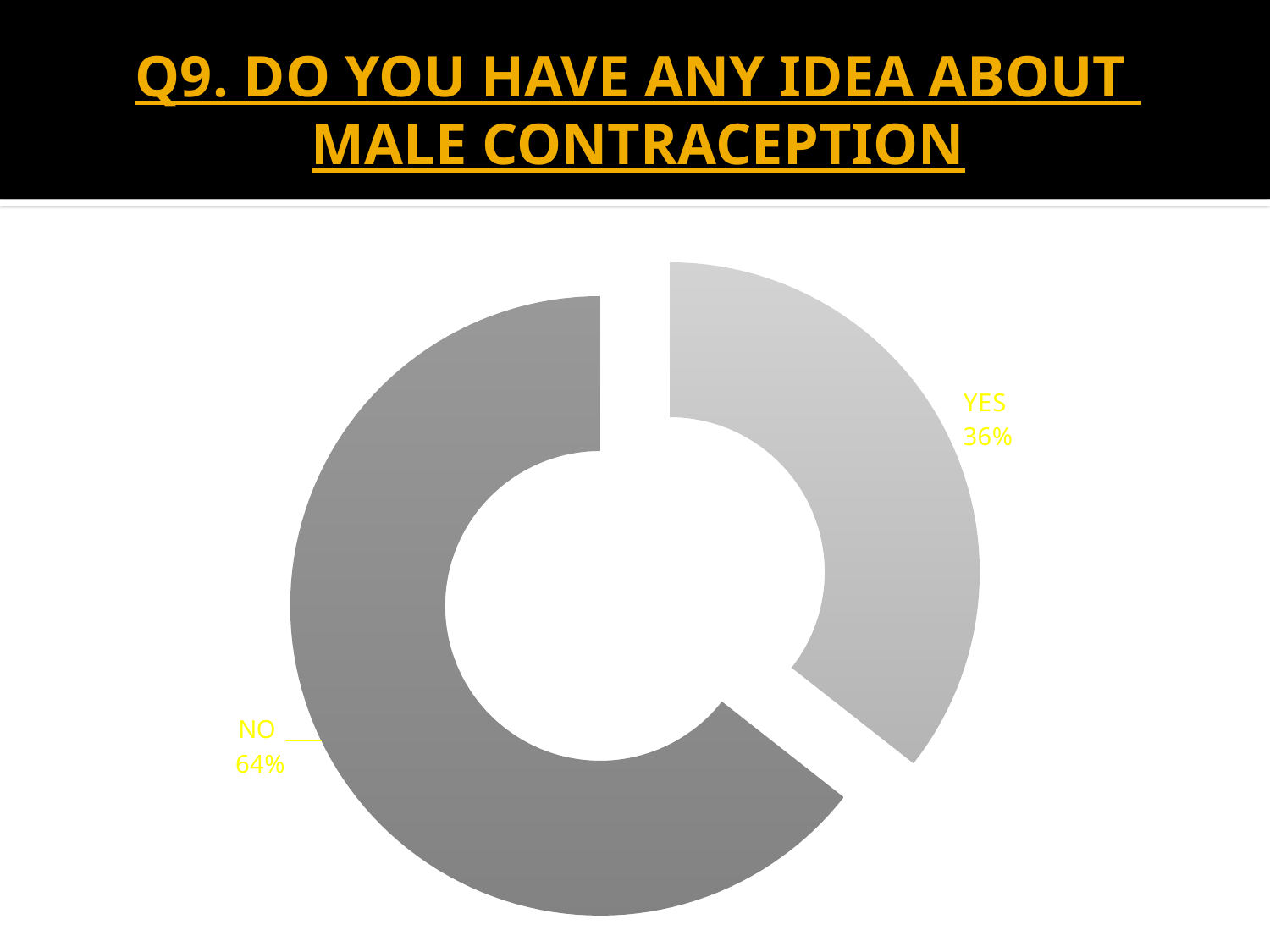
What kind of chart is shown on the slide? doughnut (pie) chart Which response has the smaller share of the chart? YES Which slice is shown in the darker grey colour? NO How many categories are shown in the chart? 2 What share of the chart does the NO slice represent? 64% What percentage of respondents answered NO? 64% What is the difference in percentage points between the NO and YES shares? 28 What percentage of respondents answered YES? 36% Which response has the larger share of the chart? NO What is the title of the slide? Q9. DO YOU HAVE ANY IDEA ABOUT MALE CONTRACEPTION Is the share for YES larger or smaller than the share for NO? smaller